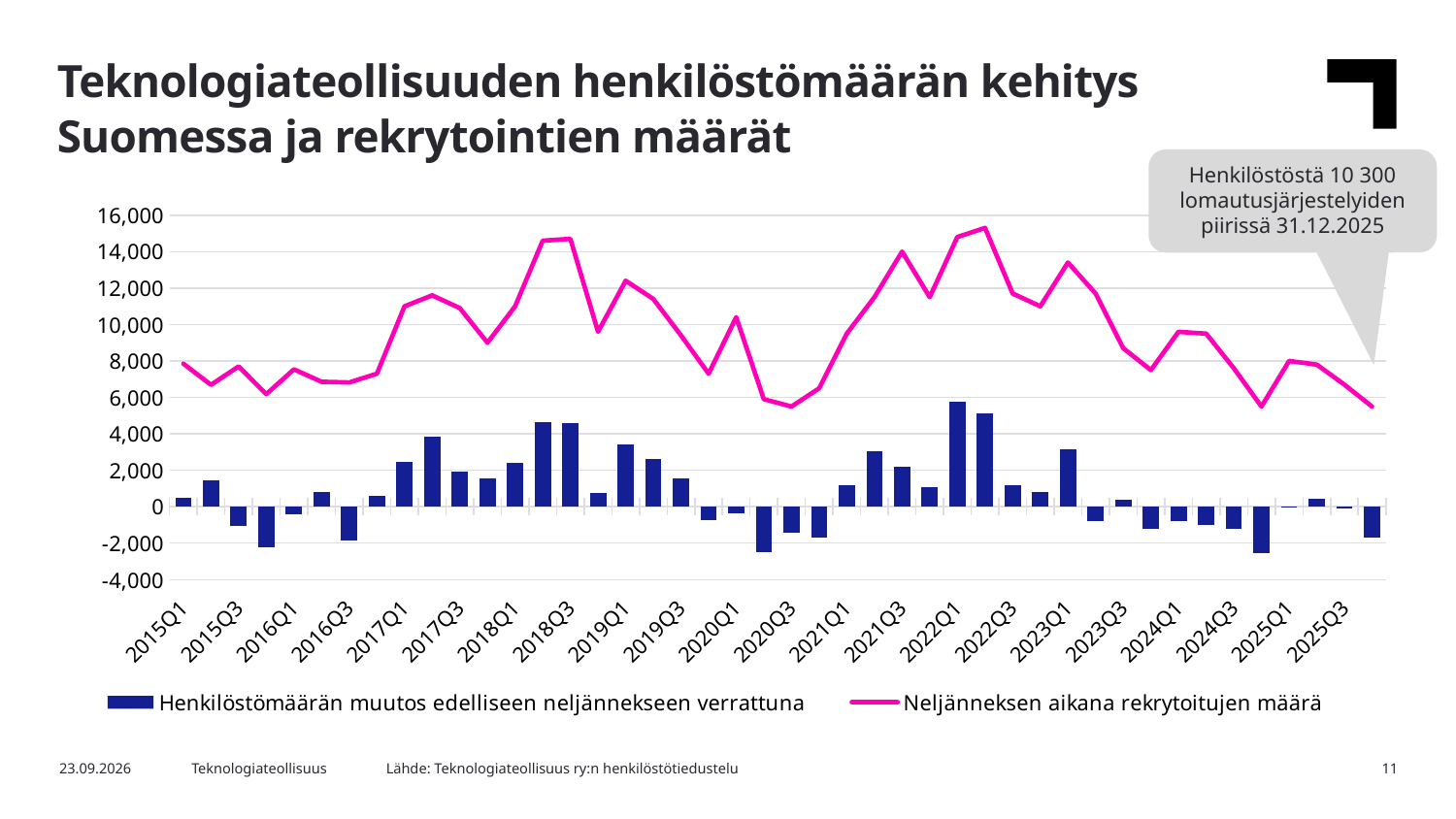
How many series does the chart legend list? 2 Is the bar value (Henkilöstömäärän muutos) at 2022Q1 greater or less than 4,000? greater Is the bar value (Henkilöstömäärän muutos) at 2020Q3 greater or less than 0? less Is the value of the line series (Neljänneksen aikana rekrytoitujen määrä) at 2022Q1 greater or less than 14,000? greater Which series is drawn as bars in the chart? Henkilöstömäärän muutos edelliseen neljännekseen verrattuna Does the line series (Neljänneksen aikana rekrytoitujen määrä) generally rise or fall from 2022Q1 to 2025Q3? fall Which series is drawn as a line in the chart? Neljänneksen aikana rekrytoitujen määrä What type of chart is shown on the slide? A combined bar and line chart Which is larger for the line series: the value at 2022Q1 or the value at 2020Q3? 2022Q1 In which quarter is the bar series (Henkilöstömäärän muutos edelliseen neljännekseen verrattuna) at its highest? 2022Q1